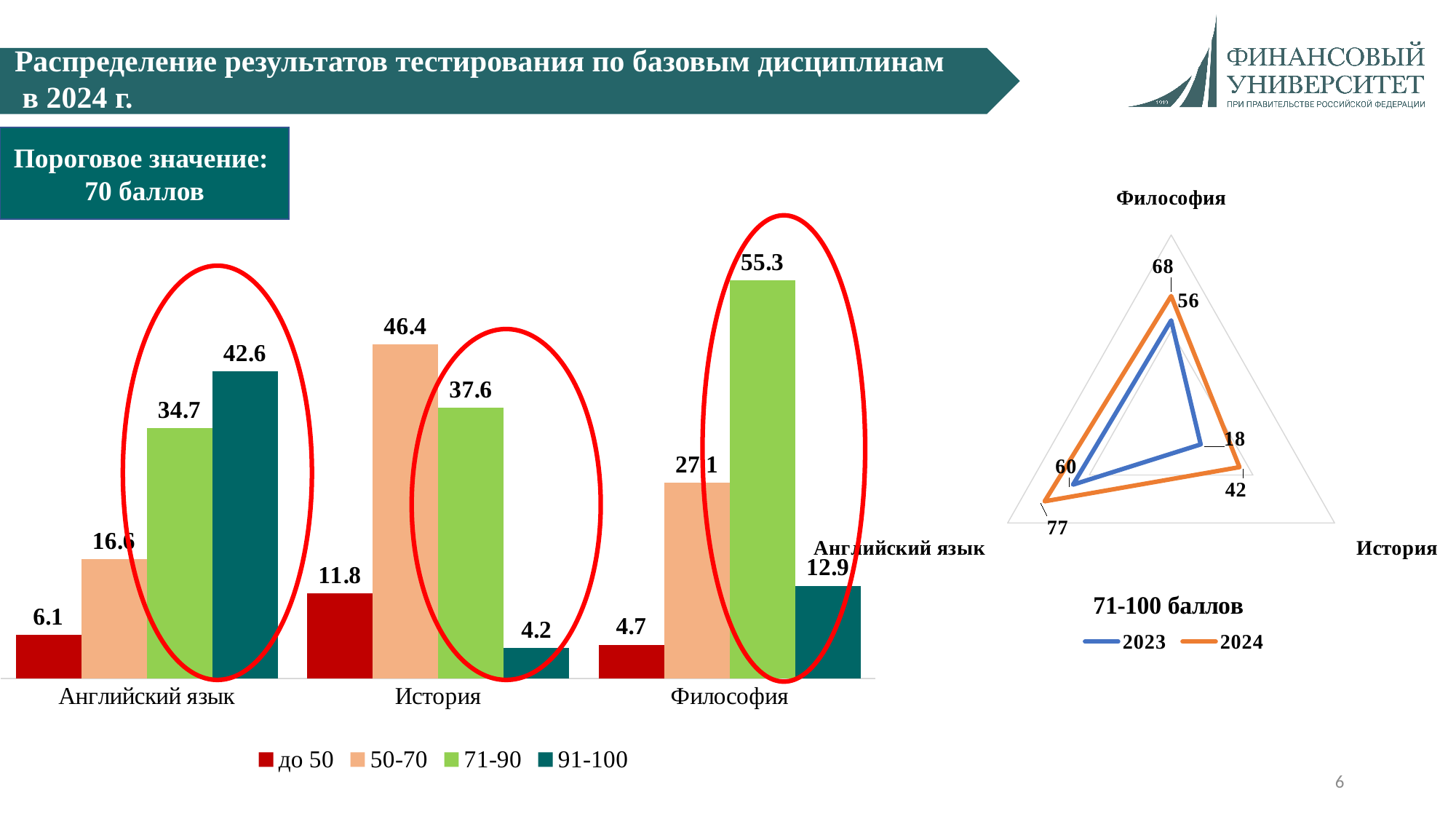
On the radar chart titled 71-100 баллов, which series has the larger value for История, 2023 or 2024? 2024 How many categories are shown on the x axis of the bar chart? 3 On the bar chart, what is the value of the до 50 series for Философия? 4.7 On the bar chart, what is the value of the 50-70 series for История? 46.4 On the bar chart, what is the value of the 71-90 series for Философия? 55.3 On the bar chart, which is larger for Английский язык: the 50-70 value or the 71-90 value? 71-90 On the radar chart titled 71-100 баллов, what is the 2024 value for Английский язык? 77 How many series does the legend of the bar chart list? 4 On the bar chart, what is the value of the 91-100 series for Английский язык? 42.6 On the bar chart, which category has the lowest value in the до 50 series? Философия On the bar chart, which category has the highest value in the 91-100 series? Английский язык On the bar chart, what is the difference between the 71-90 and 91-100 values for История? 33.4